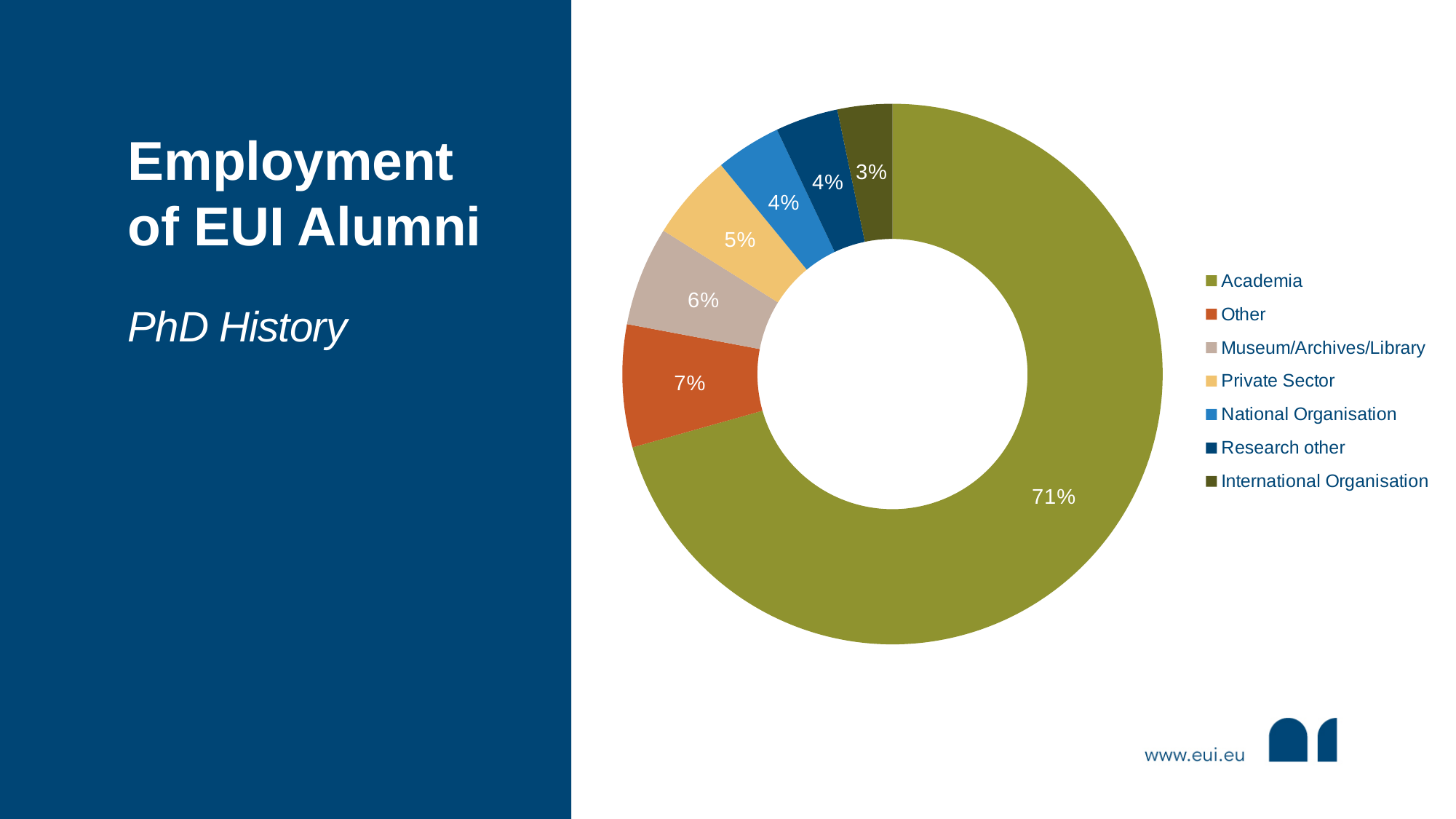
What is the difference in percentage points between Academia and Other? 64 Which category has the largest share of the chart? Academia What kind of chart is shown on the slide? Pie chart (doughnut) What is the value for International Organisation? 3% What percentage of the chart is labelled Other? 7% What is the value for Private Sector? 5% How many categories does the legend list? 7 Which is larger, the share for Museum/Archives/Library or the share for Private Sector? Museum/Archives/Library Which category has the smallest share of the chart? International Organisation What is the value for Museum/Archives/Library? 6% Which legend entry is shown in the light blue colour? National Organisation What share of PhD History alumni are employed in Academia? 71%